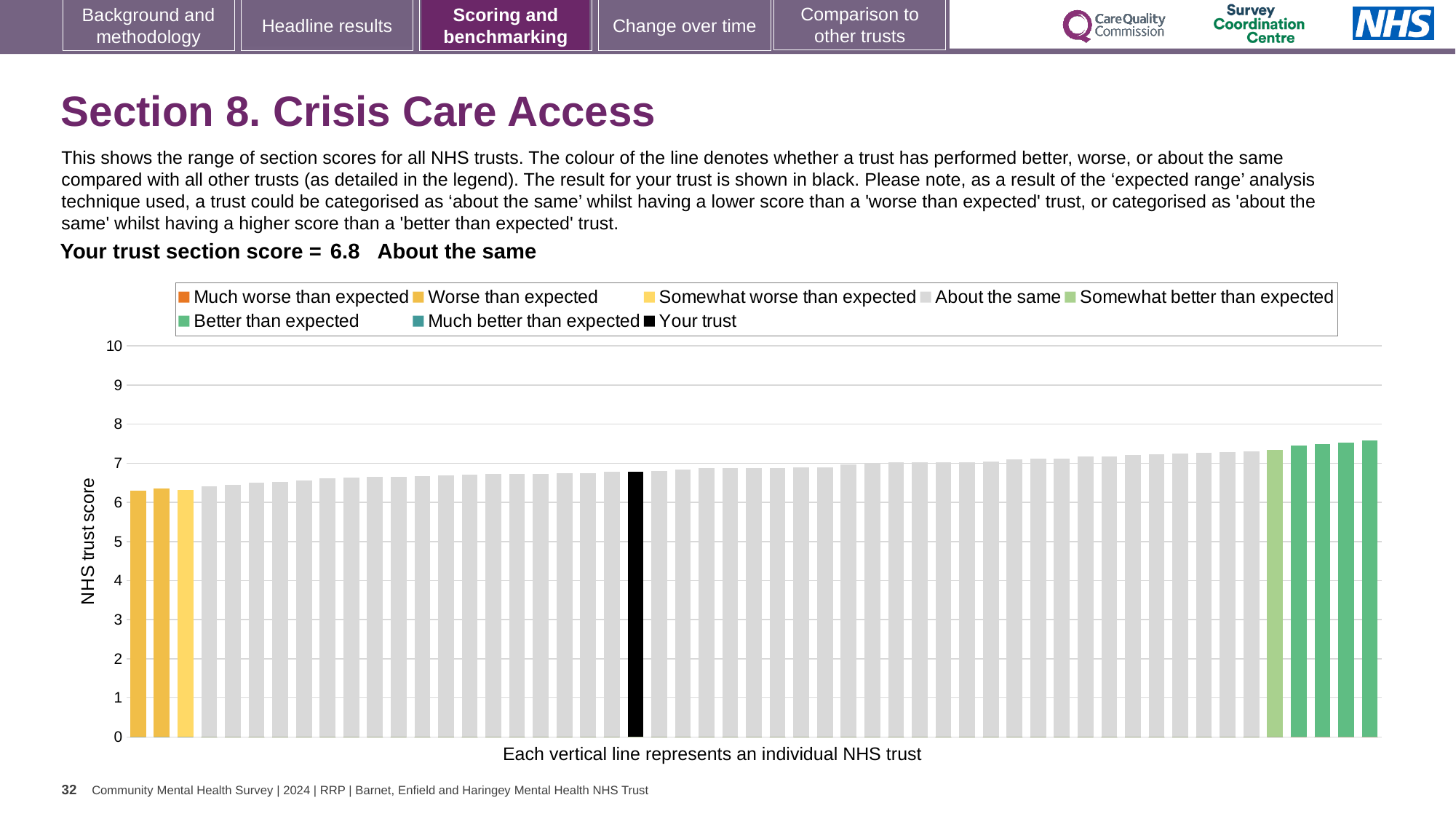
What is the section score for your trust shown on the slide? 6.8 Do the bar values rise or fall from left to right along the x axis? rise Is the value of the shortest bar greater or less than 6? greater What kind of chart is shown on the slide? bar chart Which is larger: the bar for your trust or the leftmost bar? your trust How is your trust's score categorised compared with other trusts? About the same How many bars are coloured as 'Worse than expected'? 2 What is the label on the vertical axis of the chart? NHS trust score Is the value for your trust greater or less than 6? greater How many entries does the chart legend list? 8 How many bars are coloured as 'Better than expected'? 4 Is the value of the tallest bar greater or less than 8? less